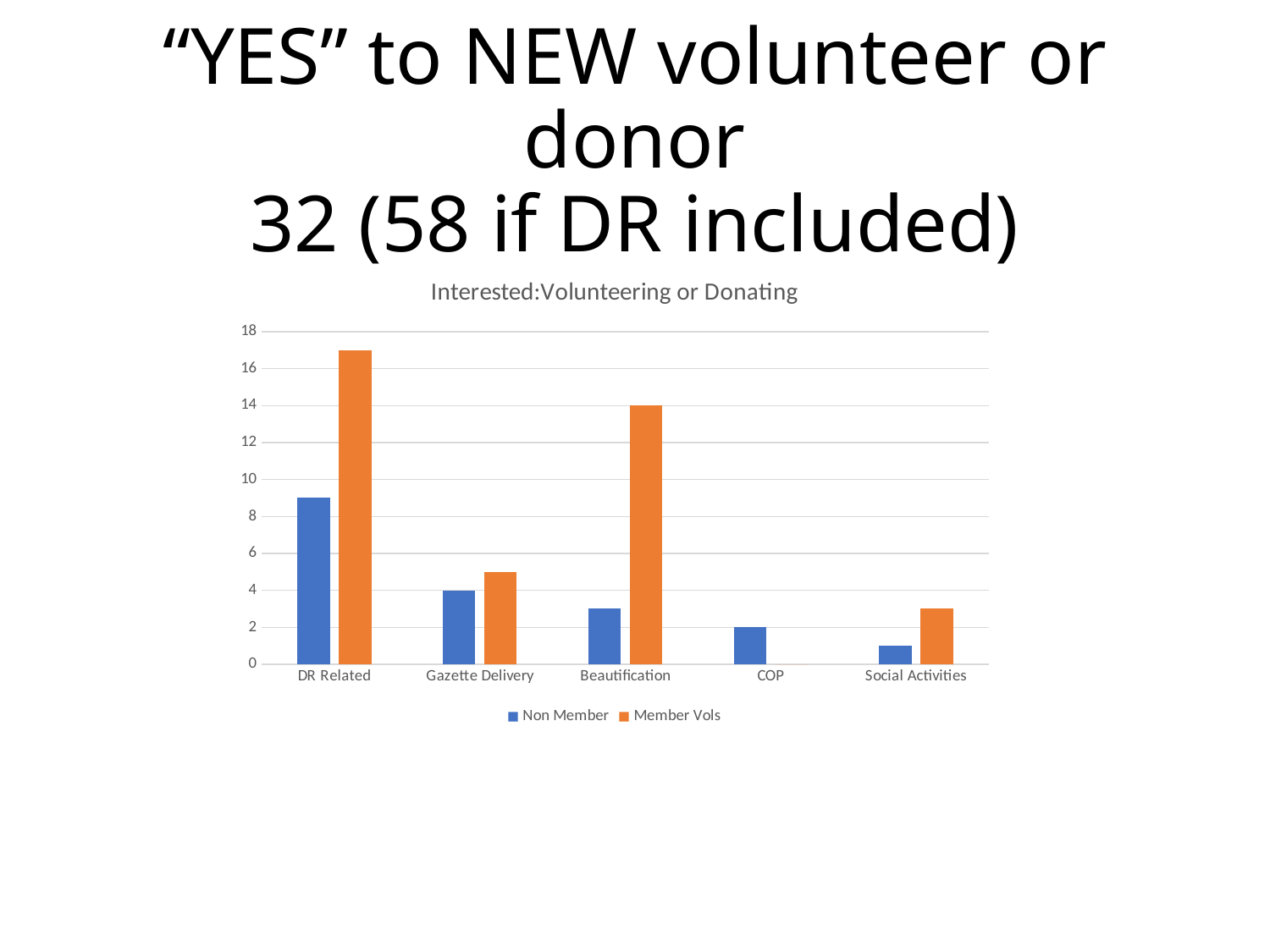
Is the Member Vols value for DR Related greater or less than 16? greater What type of chart is shown on the slide? bar chart Which category has the highest Member Vols value? DR Related What is the title of the chart? Interested:Volunteering or Donating What is the Non Member value for COP? 2 Which category has the lowest Non Member value? Social Activities What is the Member Vols value for Beautification? 14 What is the Non Member value for Gazette Delivery? 4 How many categories are shown on the x axis? 5 For Beautification, which series has the larger value, Non Member or Member Vols? Member Vols How many series does the legend list? 2 Is the Non Member value for DR Related greater or less than 8? greater